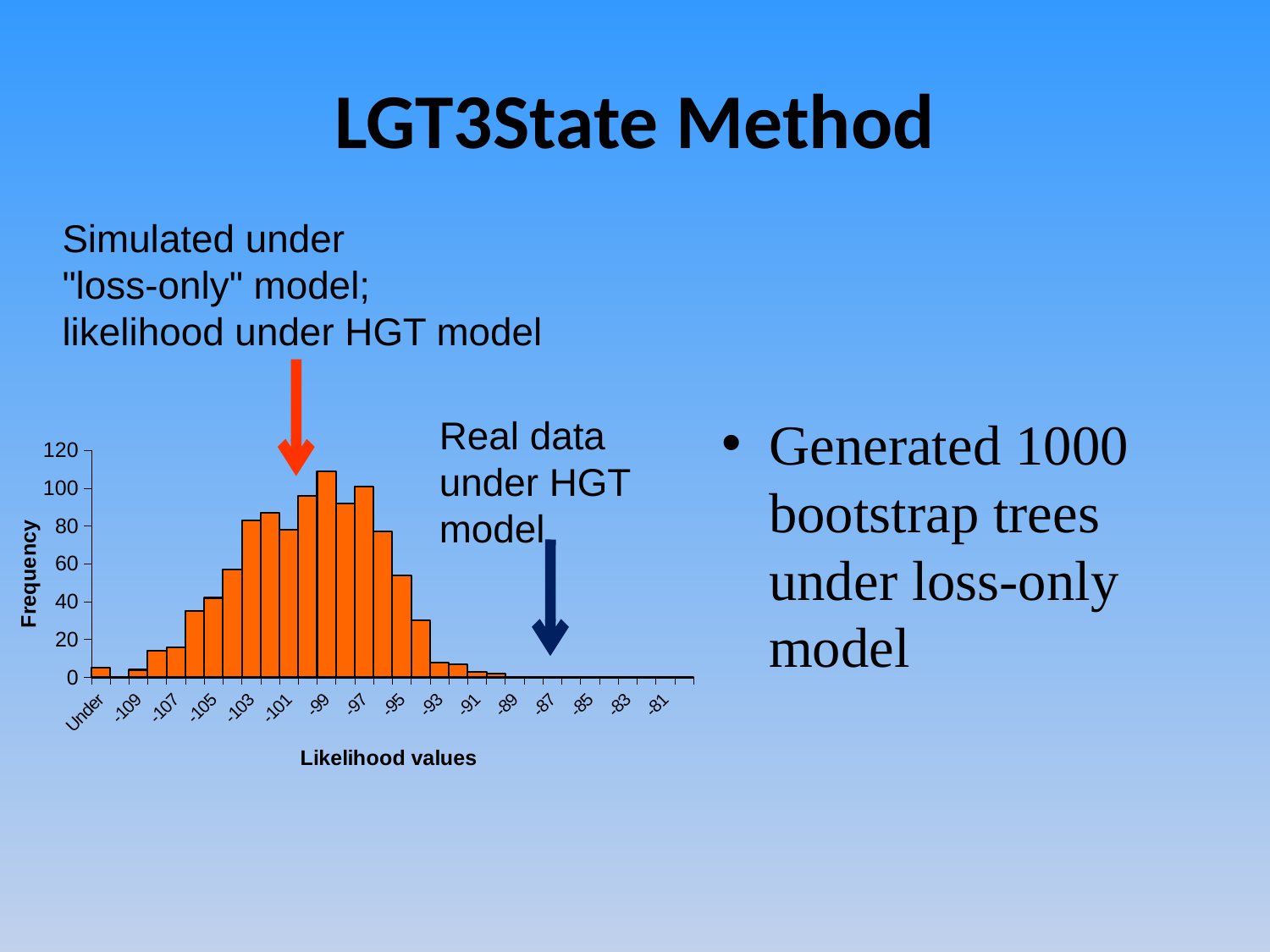
Is the frequency for likelihood value -107 greater or less than 20? less Is the frequency for likelihood value -93 greater or less than 20? less What kind of chart is shown on the slide? bar chart Do the frequencies rise or fall along the x axis from -99 to -91? fall Which has the higher frequency, likelihood value -99 or likelihood value -93? -99 Is the frequency for likelihood value -109 greater or less than 20? less Which likelihood value has the highest frequency in the chart? -99 What is the title of the x axis of the chart? Likelihood values Which has the lower frequency, likelihood value -107 or likelihood value -103? -107 What is the title of the y axis of the chart? Frequency